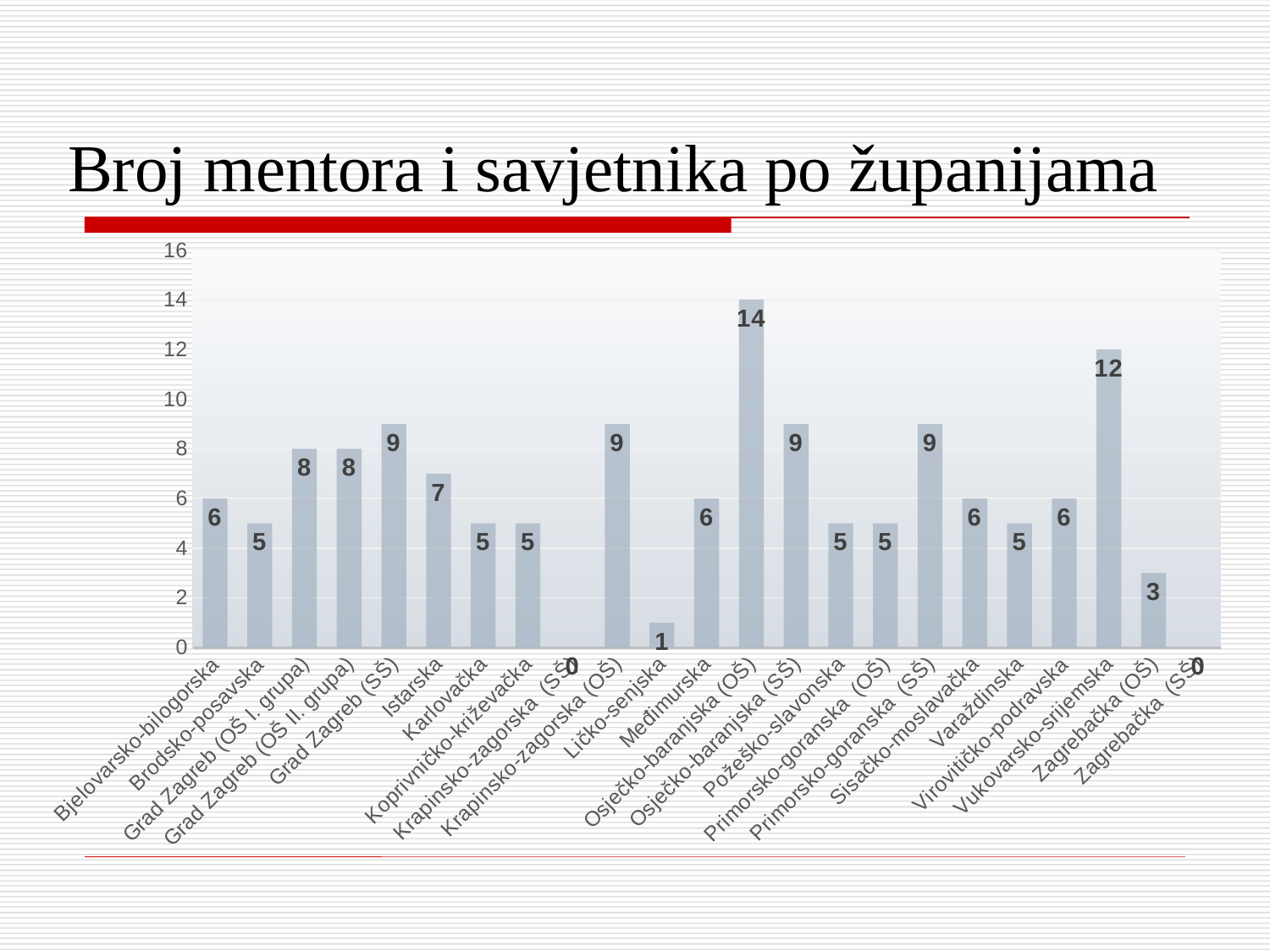
What is the difference between the values for Grad Zagreb (SŠ) and Brodsko-posavska? 4 Is the value for Vukovarsko-srijemska greater or less than 10? greater What is the value for Osječko-baranjska (OŠ)? 14 Which category has the highest value? Osječko-baranjska (OŠ) What is the value for Vukovarsko-srijemska? 12 What is the value for Istarska? 7 What is the value for Zagrebačka (OŠ)? 3 How many categories are shown on the x axis? 23 Which is larger, the value for Istarska or the value for Karlovačka? Istarska What is the value for Ličko-senjska? 1 What is the difference between the values for Osječko-baranjska (OŠ) and Vukovarsko-srijemska? 2 What kind of chart is shown on the slide? Bar chart